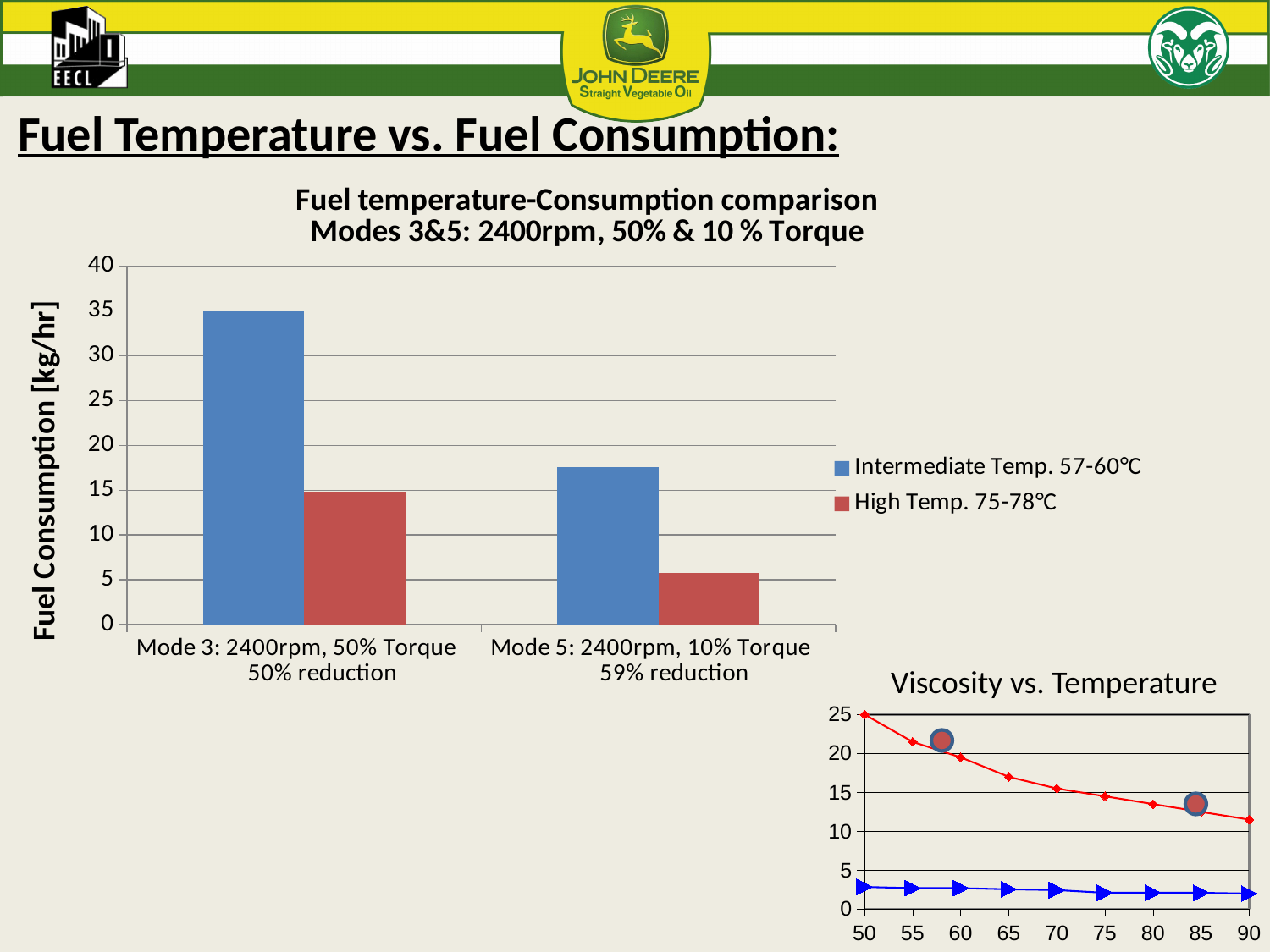
In the 'Fuel temperature-Consumption comparison' chart, how many series does the legend list? 2 In the 'Viscosity vs. Temperature' chart, is the red line's value at 50 greater or less than 20? greater In the 'Fuel temperature-Consumption comparison' chart, for Mode 3, which series has the larger value: Intermediate Temp. 57-60℃ or High Temp. 75-78℃? Intermediate Temp. 57-60℃ What kind of chart is the 'Fuel temperature-Consumption comparison' chart? bar chart In the 'Fuel temperature-Consumption comparison' chart, is the High Temp. 75-78℃ value for Mode 5 greater or less than 10? less In the 'Fuel temperature-Consumption comparison' chart, is the Intermediate Temp. 57-60℃ value for Mode 5 greater or less than 15? greater In the 'Fuel temperature-Consumption comparison' chart, how many categories are shown on the x axis? 2 In the 'Fuel temperature-Consumption comparison' chart, what is the label of the y axis? Fuel Consumption [kg/hr] In the 'Fuel temperature-Consumption comparison' chart, which category has the higher Intermediate Temp. 57-60℃ value? Mode 3: 2400rpm, 50% Torque In the 'Viscosity vs. Temperature' chart, does the red line rise or fall as temperature increases from 50 to 90? fall What kind of chart is the 'Viscosity vs. Temperature' chart? line chart